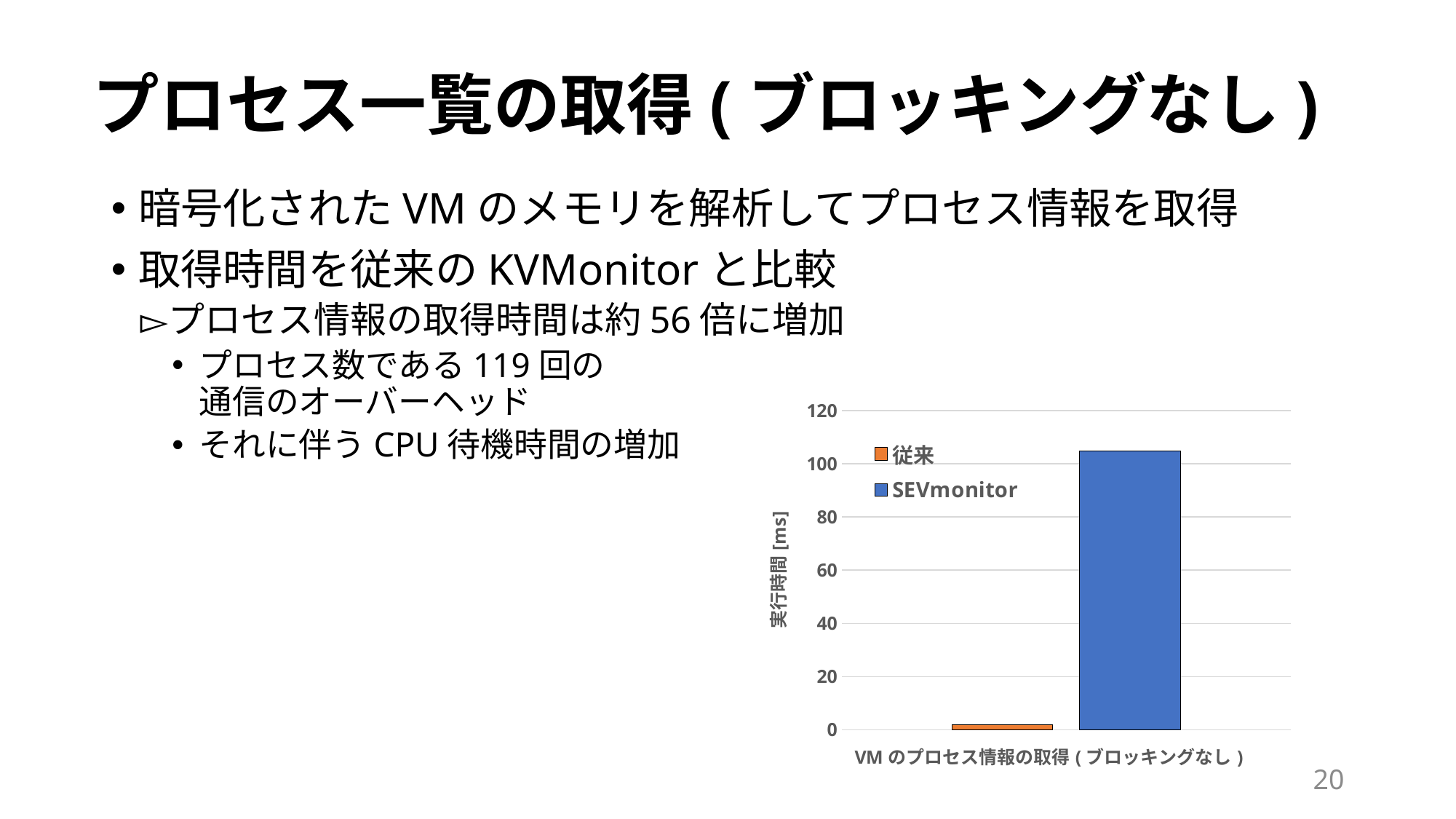
What is the label of the vertical axis of the chart? 実行時間 [ms] Which series has the highest value in the chart? SEVmonitor Which series has the lowest value in the chart? 従来 Is the value for 従来 greater or less than 20? less How many series does the chart legend list? 2 Is the value for SEVmonitor greater or less than 100? greater How many categories are plotted on the x axis of the chart? 1 What kind of chart is shown on the slide? bar chart Which series has the taller bar, 従来 or SEVmonitor? SEVmonitor Which colour represents the SEVmonitor series in the chart? blue Is the value for SEVmonitor greater or less than 120? less